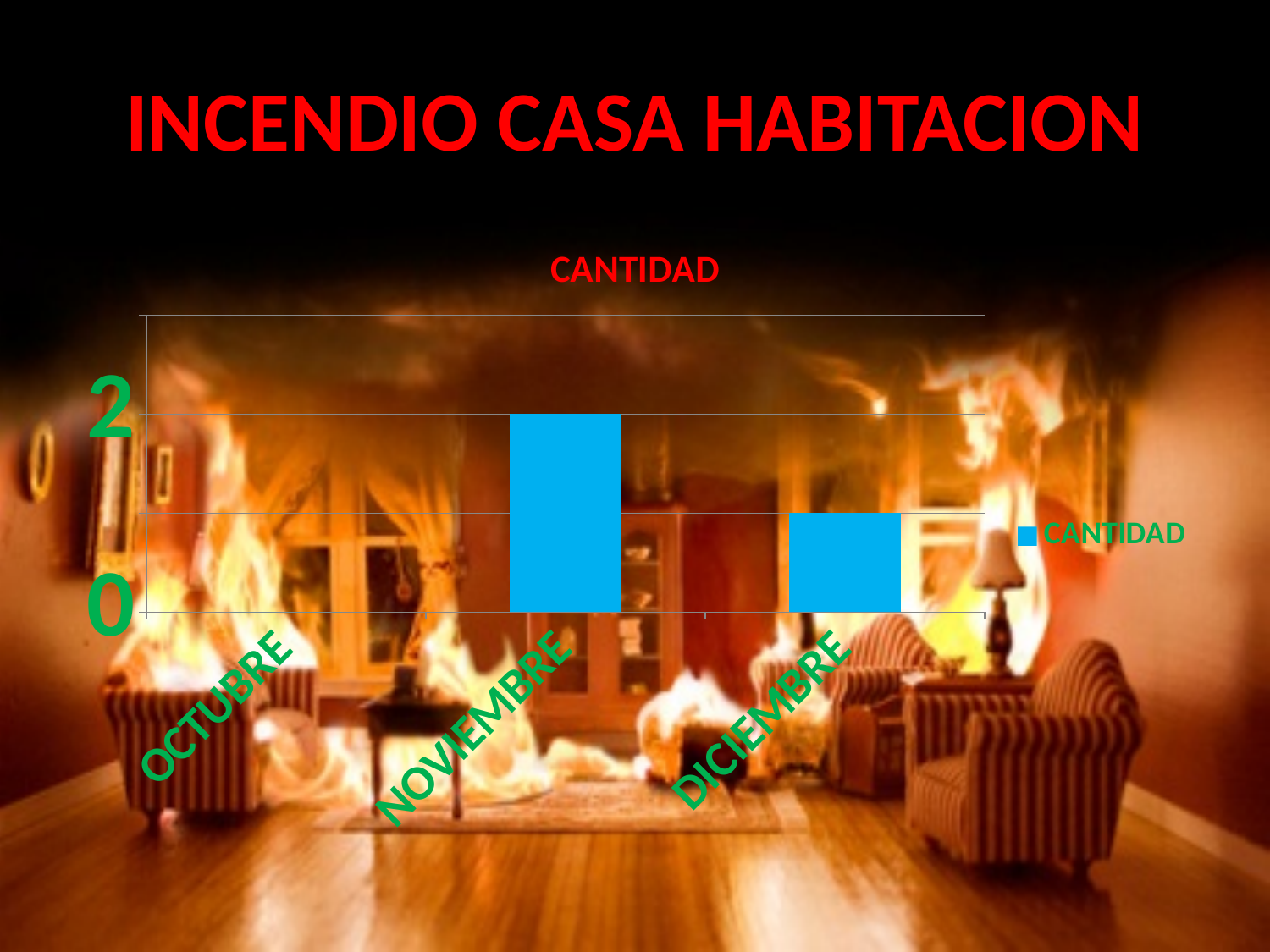
What colour are the bars in the chart? blue What is the title of the chart? CANTIDAD What kind of chart is shown on the slide? bar chart Is the value for DICIEMBRE greater or less than 2? less What is the value for NOVIEMBRE? 2 Does the value rise or fall from NOVIEMBRE to DICIEMBRE? fall Which month has the lowest value? OCTUBRE Which is larger, the value for NOVIEMBRE or the value for DICIEMBRE? NOVIEMBRE How many months are shown on the x axis? 3 Which month has the highest value? NOVIEMBRE How many series does the legend list? 1 Is the value for DICIEMBRE greater or less than 0? greater